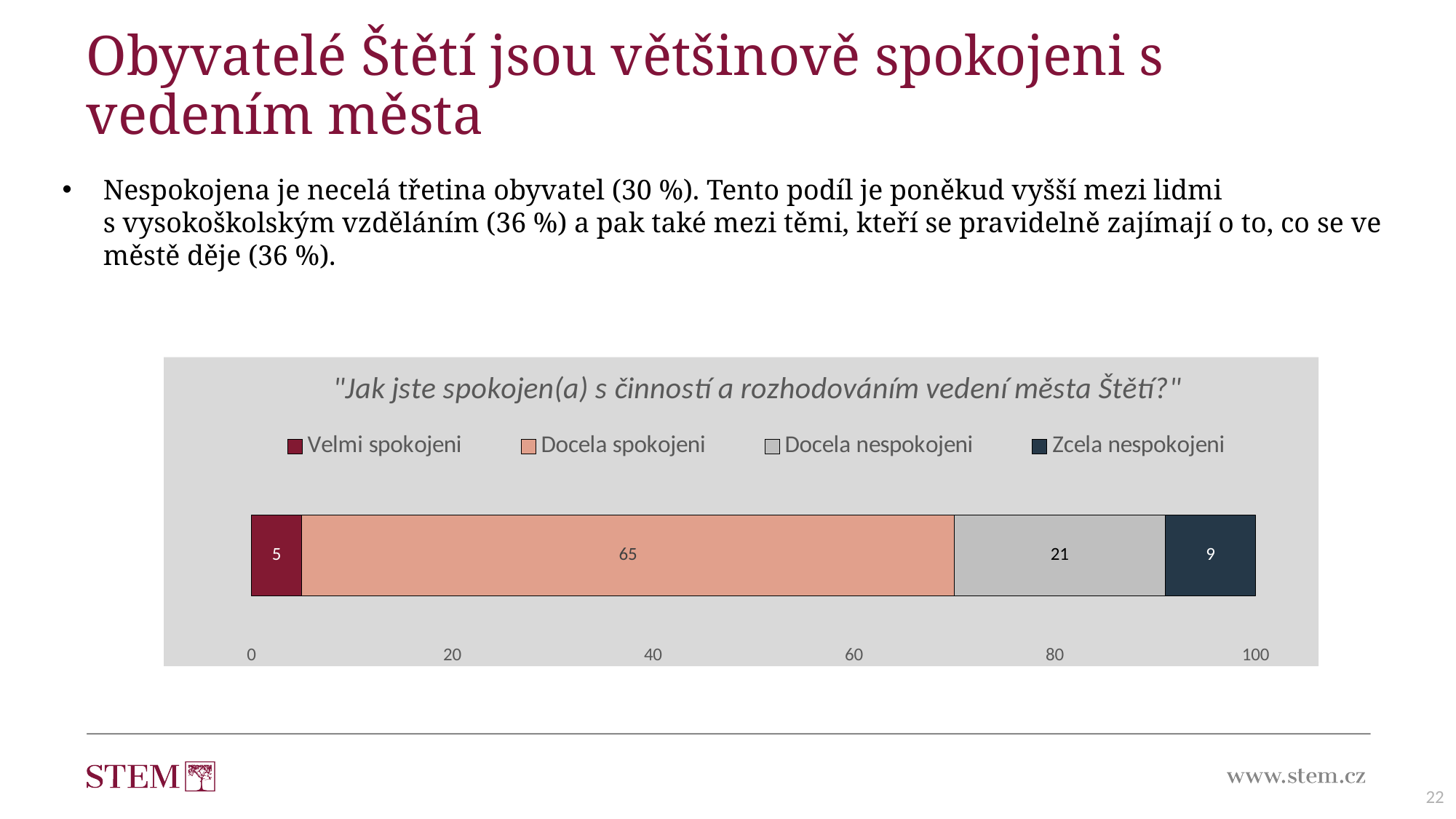
Which is larger, the value for "Docela nespokojeni" or the value for "Zcela nespokojeni"? Docela nespokojeni What is the value for "Docela nespokojeni"? 21 Which series has the highest value? Docela spokojeni Which series has the lowest value? Velmi spokojeni What is the title of the chart? "Jak jste spokojen(a) s činností a rozhodováním vedení města Štětí?" What is the difference between the values for "Docela nespokojeni" and "Zcela nespokojeni"? 12 What is the value for "Zcela nespokojeni"? 9 What is the value for "Docela spokojeni"? 65 What is the value for "Velmi spokojeni"? 5 What is the total of the stacked bar? 100 How many series does the legend list? 4 What kind of chart is shown on the slide? Stacked bar chart